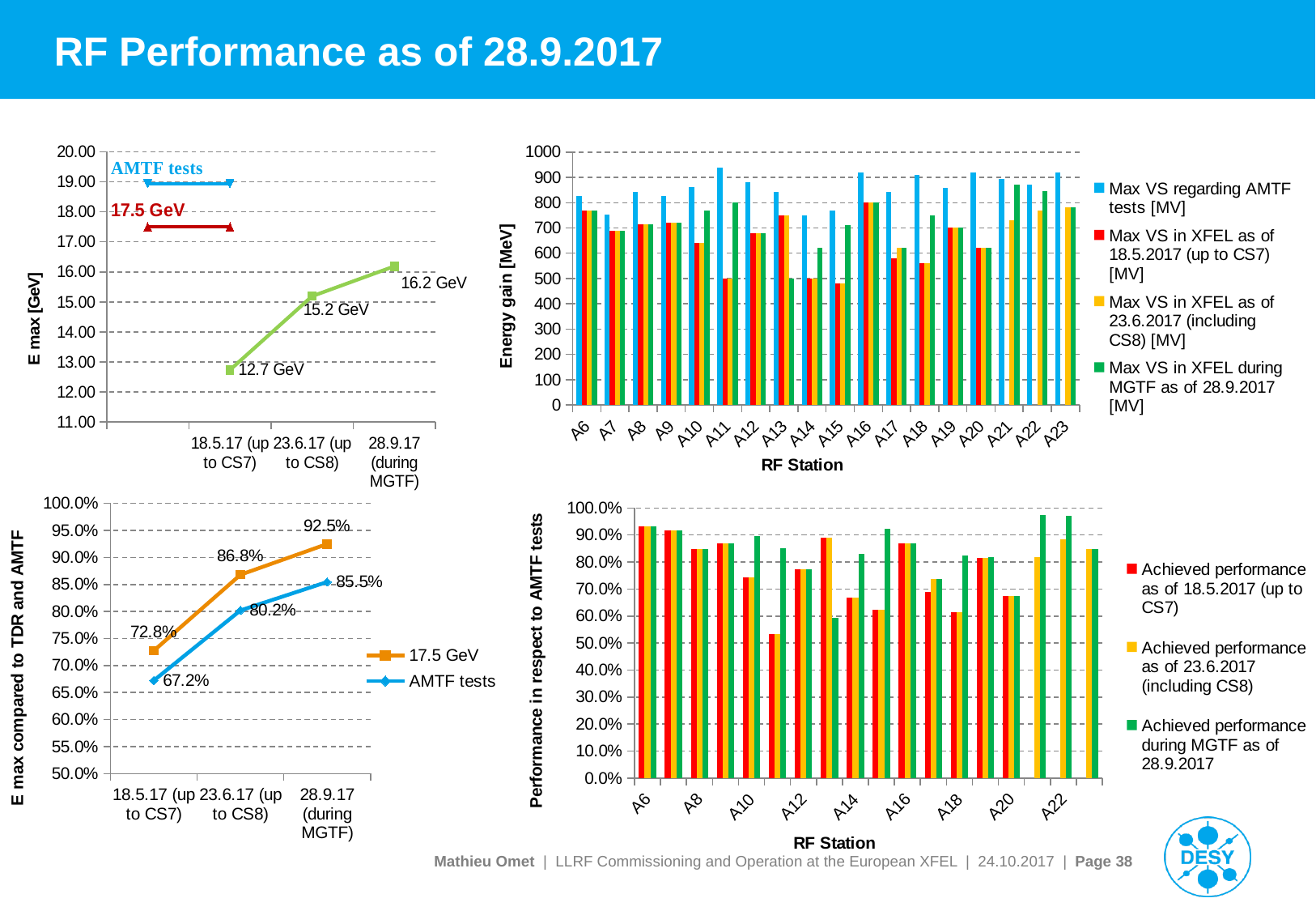
In the top-left E max [GeV] chart, by how much did E max increase from 18.5.17 to 28.9.17? 3.5 GeV In the bottom-left chart (E max compared to TDR and AMTF), which series has the higher value at 23.6.17 (up to CS8): 17.5 GeV or AMTF tests? 17.5 GeV In the top-left E max [GeV] chart, what is the value labelled for 18.5.17 (up to CS7)? 12.7 GeV In the bottom-left chart (E max compared to TDR and AMTF), what is the value of the AMTF tests series at 18.5.17 (up to CS7)? 67.2% In the top-left E max [GeV] chart, what is the value labelled for 28.9.17 (during MGTF)? 16.2 GeV In the top-right Energy gain [MeV] chart, how many series does the legend list? 4 In the top-right Energy gain [MeV] chart, is the value of 'Max VS regarding AMTF tests [MV]' for A11 greater or less than 900? greater In the bottom-right chart (Performance in respect to AMTF tests), is the value of 'Achieved performance as of 18.5.2017 (up to CS7)' for A11 greater or less than 60.0%? less In the bottom-left chart (E max compared to TDR and AMTF), what is the value of the 17.5 GeV series at 28.9.17 (during MGTF)? 92.5% In the top-right Energy gain [MeV] chart, how many RF stations are shown on the x axis? 18 In the top-left E max [GeV] chart, do the plotted values rise or fall from left to right? rise In the bottom-left chart (E max compared to TDR and AMTF), how many series does the legend list? 2